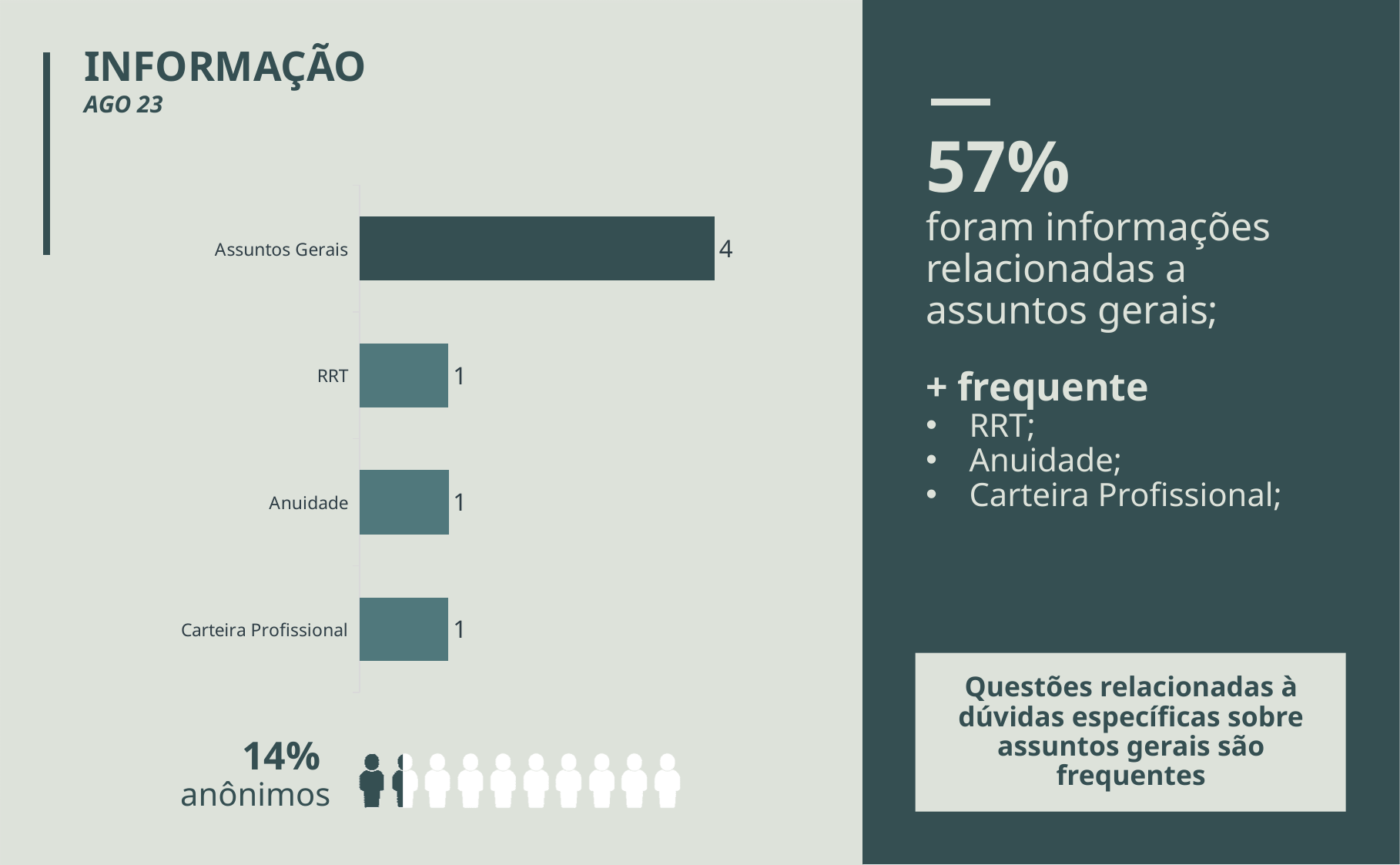
What is the value for Anuidade? 1 What is the value for Carteira Profissional? 1 What is the value for RRT? 1 How many categories are shown in the bar chart? 4 Which category has the highest value? Assuntos Gerais Which category is listed at the top of the bar chart? Assuntos Gerais What percentage of the slide's figure is labelled as anônimos? 14% What is the value for Assuntos Gerais? 4 What is the difference between the values for Assuntos Gerais and RRT? 3 What kind of chart is shown on the slide? Bar chart What is the total of all the values shown in the bar chart? 7 Which is larger, the value for Assuntos Gerais or the value for Anuidade? Assuntos Gerais